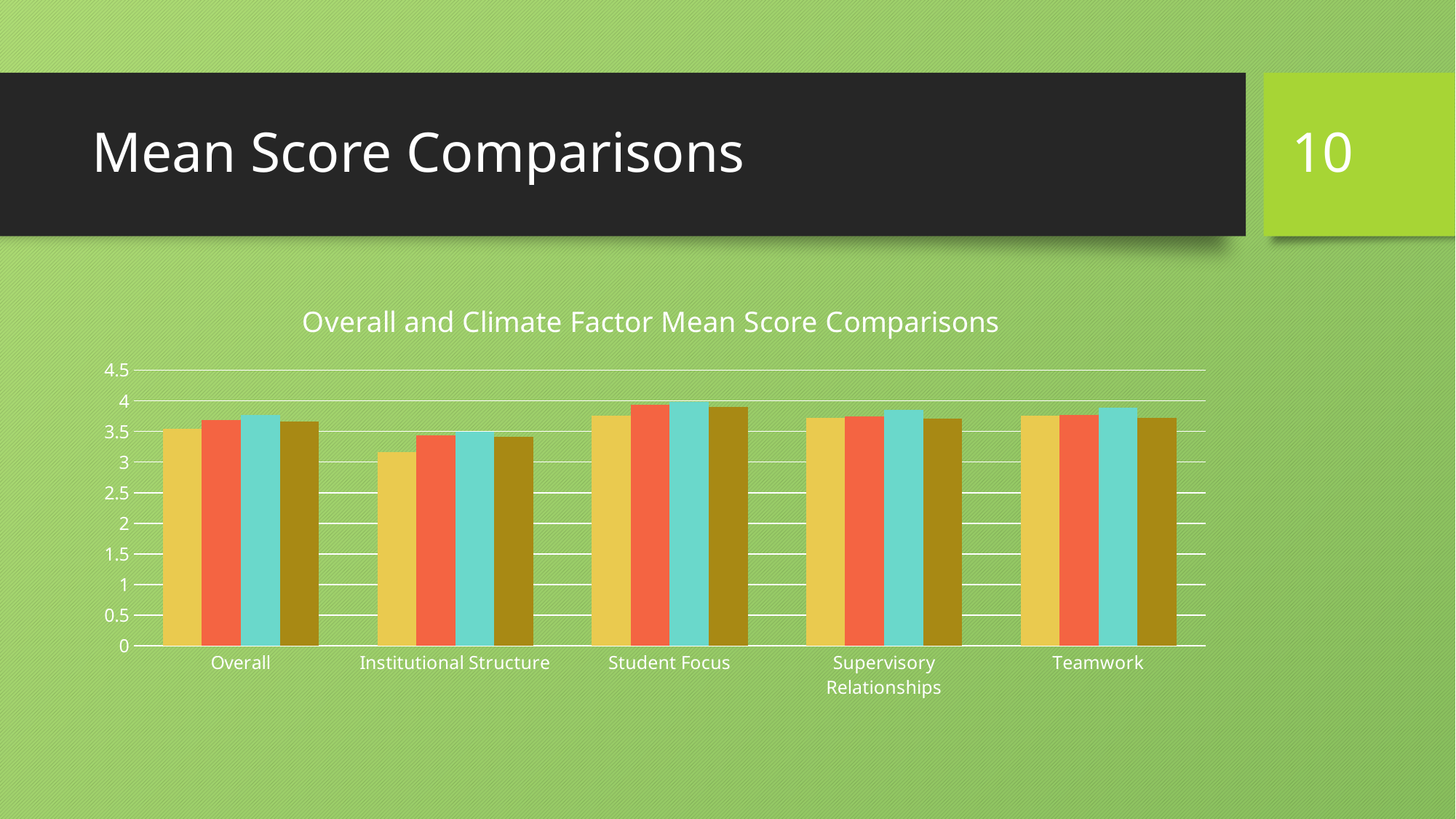
What kind of chart is shown on the slide? bar chart Which category has higher bars, Student Focus or Institutional Structure? Student Focus Which category has the lowest bars in the chart? Institutional Structure How many categories are shown on the x axis of the chart? 5 How many bars are plotted for each category in the chart? 4 What is the highest value shown on the y axis of the chart? 4.5 Are the bars for Teamwork greater or less than 3.5? greater Is the first (yellow) bar for Institutional Structure greater or less than 3.5? less Is the first (yellow) bar for Student Focus greater or less than 3.5? greater What is the title of the chart? Overall and Climate Factor Mean Score Comparisons Which category has the highest bars in the chart? Student Focus